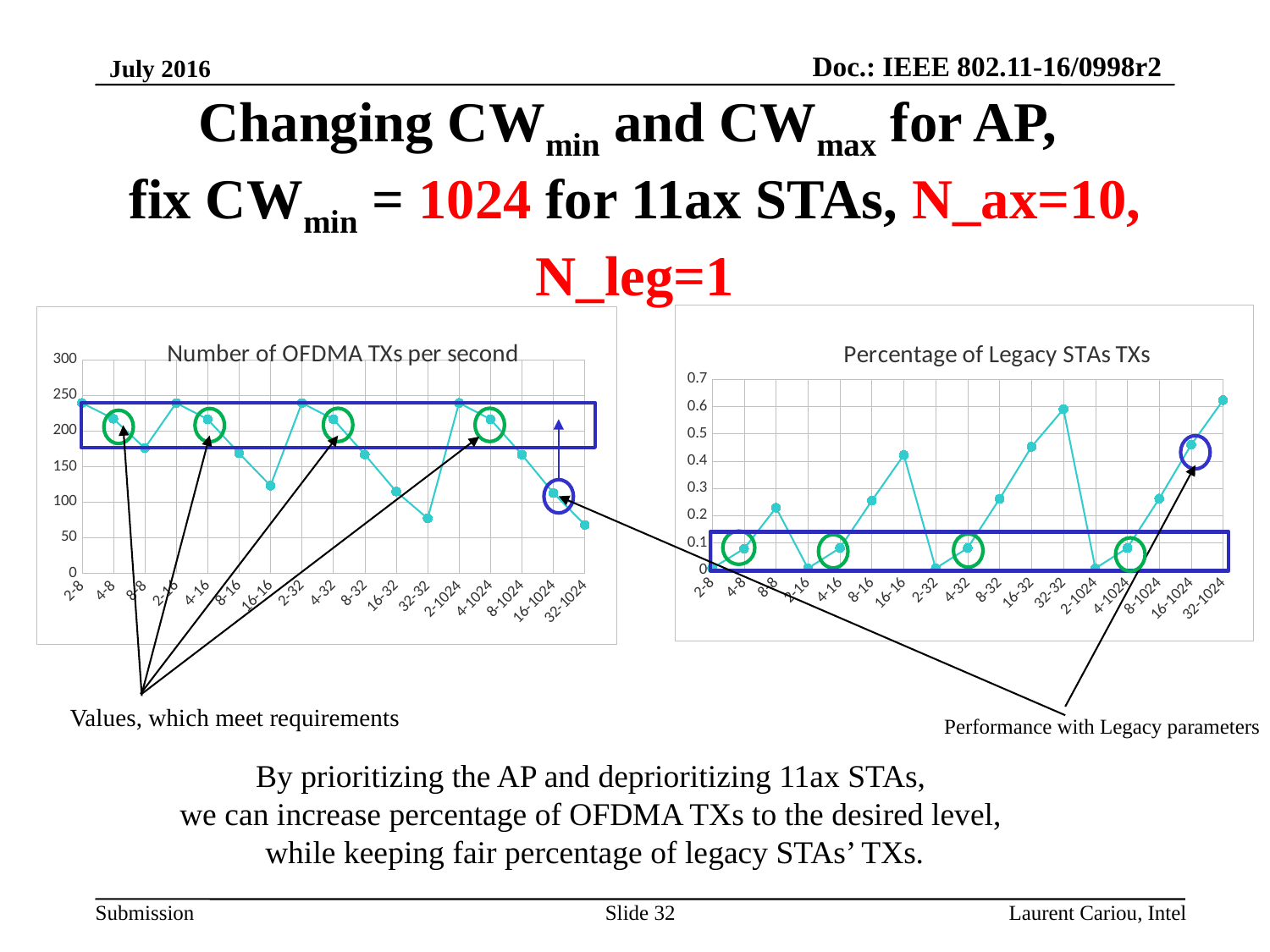
In the right chart "Percentage of Legacy STAs TXs", is the value for 2-16 greater or less than 0.1? less In the right chart "Percentage of Legacy STAs TXs", is the value for 16-16 greater or less than 0.3? greater In the left chart "Number of OFDMA TXs per second", is the value for 2-8 greater or less than 200? greater What type of chart is the left chart titled "Number of OFDMA TXs per second"? line chart In the right chart "Percentage of Legacy STAs TXs", how many categories are shown on the x axis? 17 In the left chart "Number of OFDMA TXs per second", which is larger, the value for 2-8 or the value for 16-16? 2-8 In the right chart "Percentage of Legacy STAs TXs", which is larger, the value for 32-32 or the value for 2-32? 32-32 In the left chart "Number of OFDMA TXs per second", how many categories are shown on the x axis? 17 What is the title of the right chart? Percentage of Legacy STAs TXs